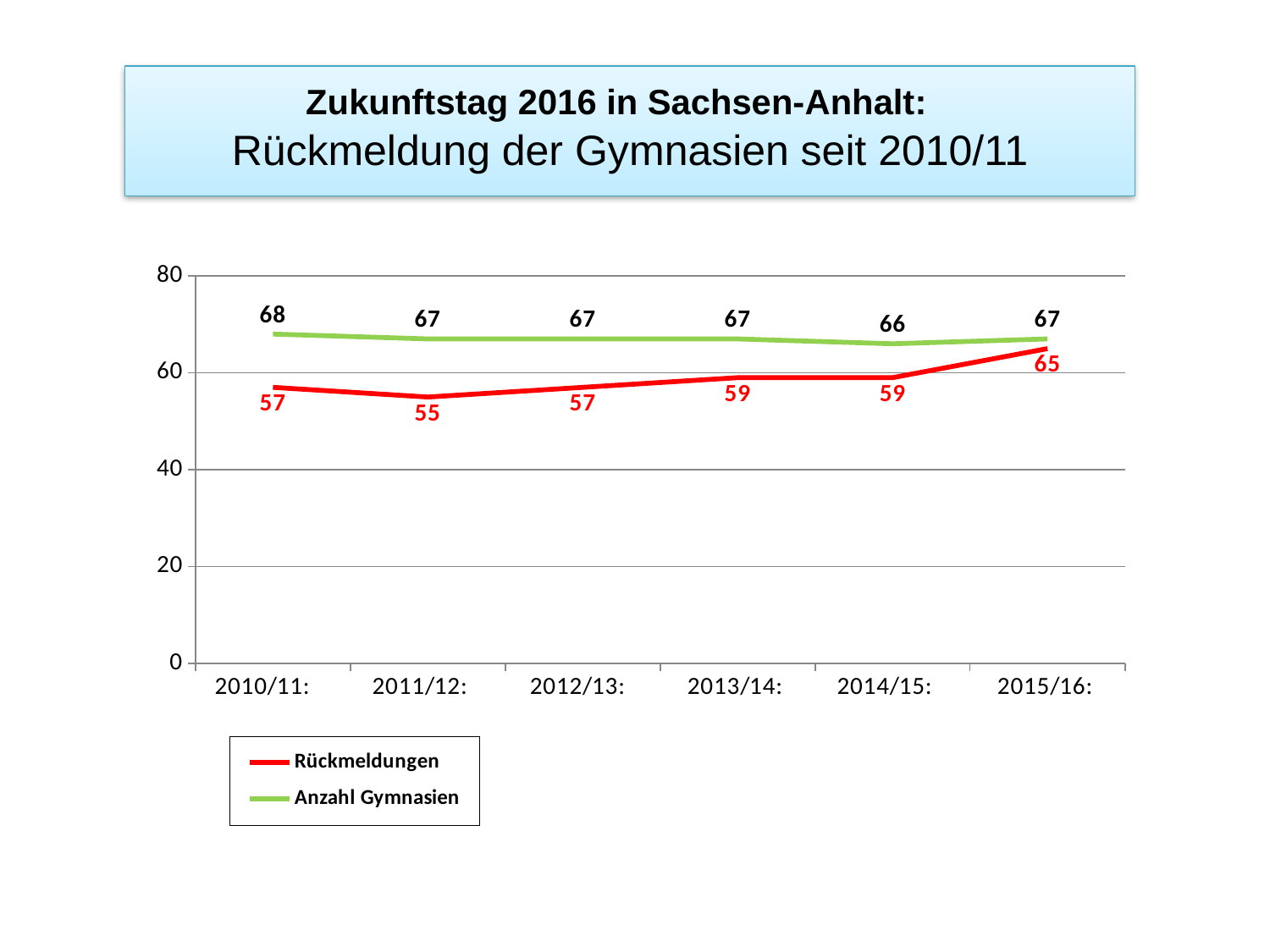
In which school year is Rückmeldungen lowest? 2011/12 How many series does the legend list? 2 What is the difference between Anzahl Gymnasien and Rückmeldungen in 2015/16? 2 What is the value of Anzahl Gymnasien for 2010/11? 68 In which school year is Rückmeldungen highest? 2015/16 What is the difference between Anzahl Gymnasien and Rückmeldungen in 2010/11? 11 Which is larger in 2013/14: Rückmeldungen or Anzahl Gymnasien? Anzahl Gymnasien What is the value of Rückmeldungen for 2015/16? 65 What kind of chart is shown on the slide? line chart What is the value of Rückmeldungen for 2011/12? 55 In which school year is Anzahl Gymnasien lowest? 2014/15 How many school years are shown on the x axis? 6